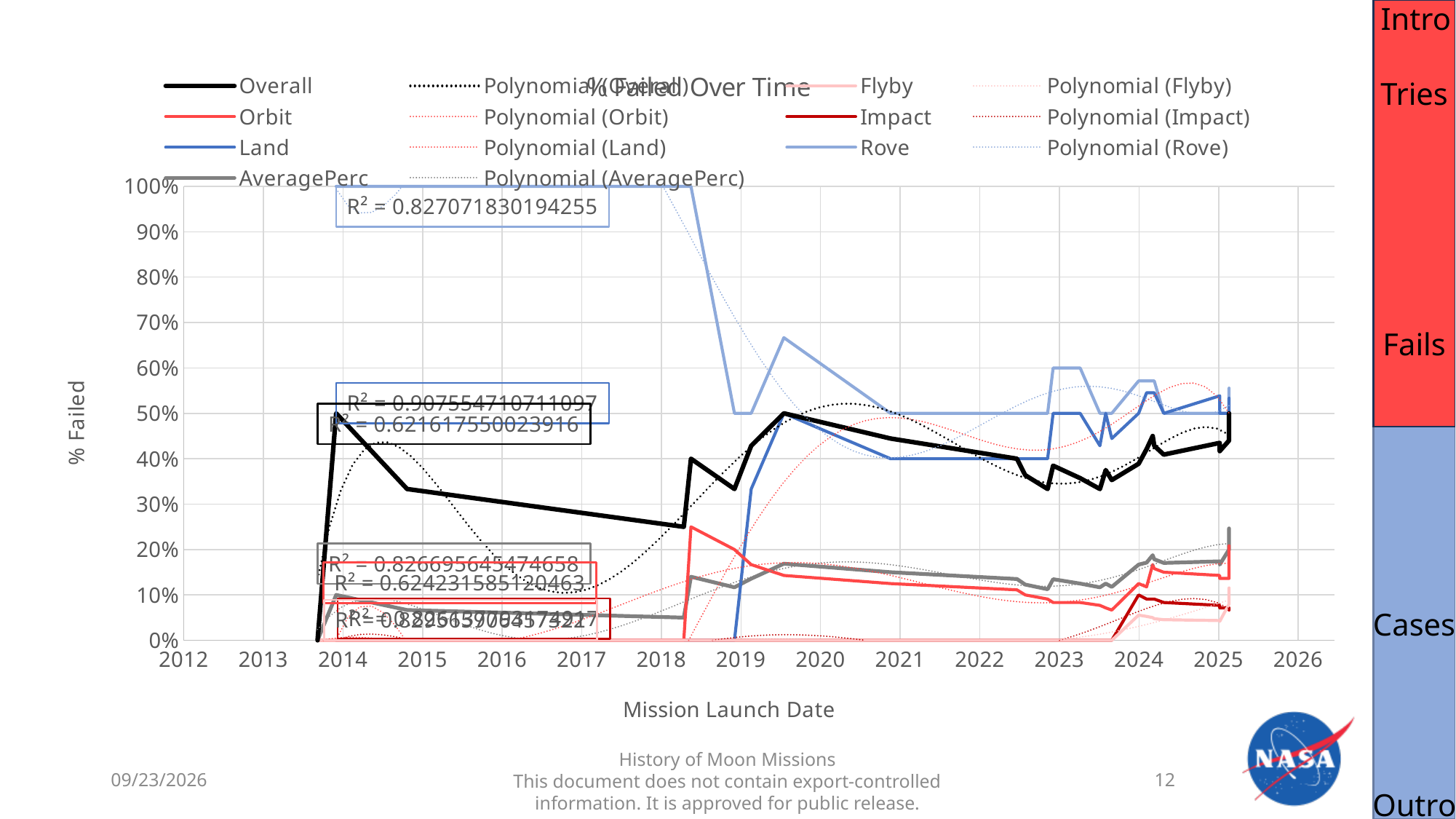
What is the x-axis title of the chart? Mission Launch Date In 2024, which is larger, the value for Overall or the value for AveragePerc? Overall Does the Overall series rise or fall between 2014 and 2018? fall Is the value for Orbit in 2020 greater or less than 20%? less What is the title of the chart? % Failed Over Time Is the value for Overall in 2017 greater or less than 20%? greater In 2021, which is larger, the value for Rove or the value for Orbit? Rove Is the peak value for Rove around 2019-2020 greater or less than 60%? greater What kind of chart is shown on the slide? line chart Which series reaches the highest value on the chart? Rove How many series does the legend list? 14